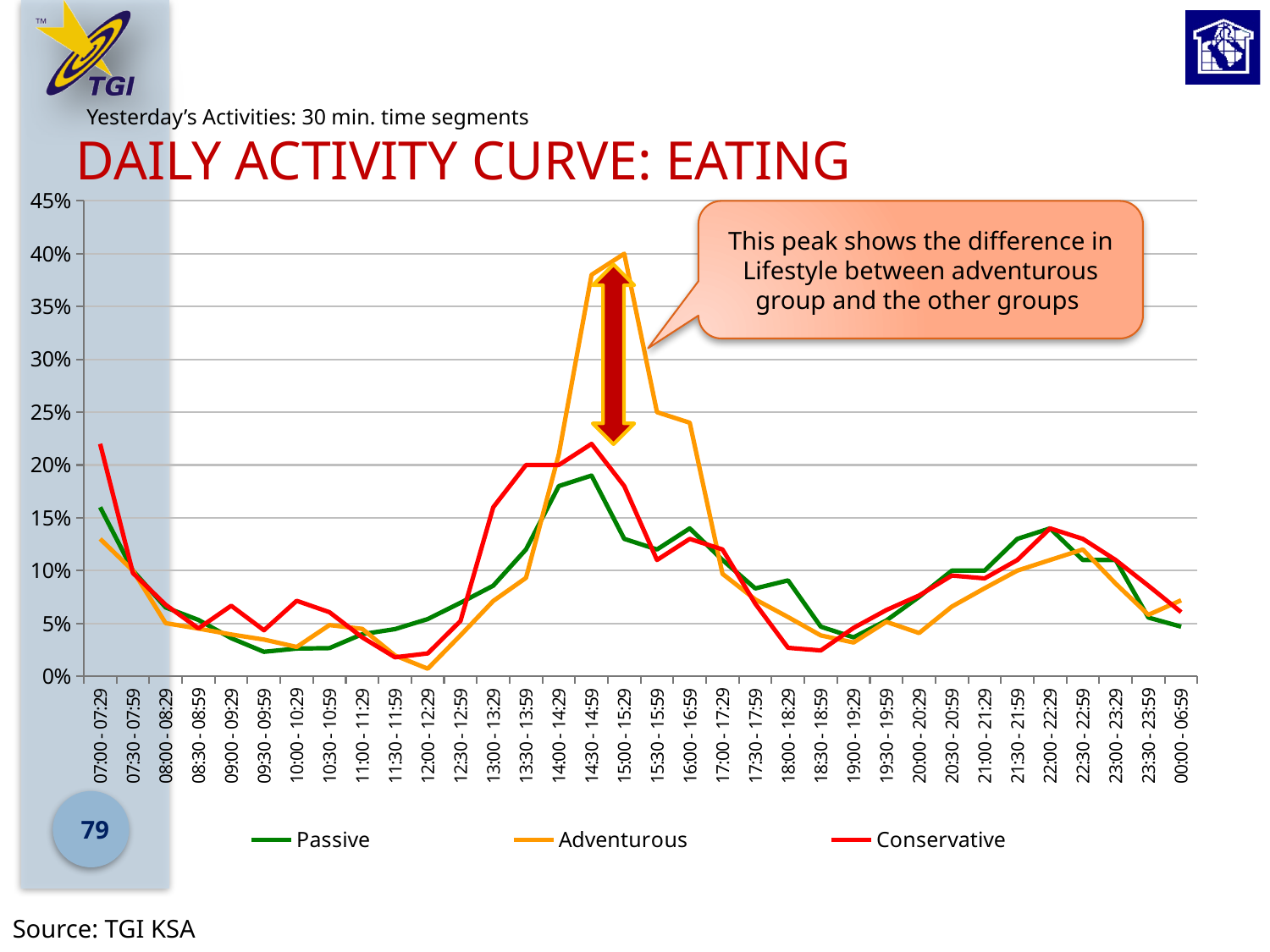
Is the value for Adventurous at 12:00 - 12:29 greater or less than 5%? less Is the value for Adventurous at 15:00 - 15:29 greater or less than 35%? greater How many series does the legend list? 3 Is the value for Conservative at 07:00 - 07:29 greater or less than 20%? greater At 13:30 - 13:59, which is larger: Conservative or Adventurous? Conservative How many time segments are plotted along the x axis? 34 What kind of chart is shown on the slide? Line chart Does the Passive series rise or fall from 07:00 - 07:29 to 08:00 - 08:29? Fall Which series reaches the highest value on the chart? Adventurous At 15:00 - 15:29, which is larger: Adventurous or Passive? Adventurous In which time segment does the Adventurous series reach its lowest value? 12:00 - 12:29 What colour is the Adventurous line in the legend? Orange